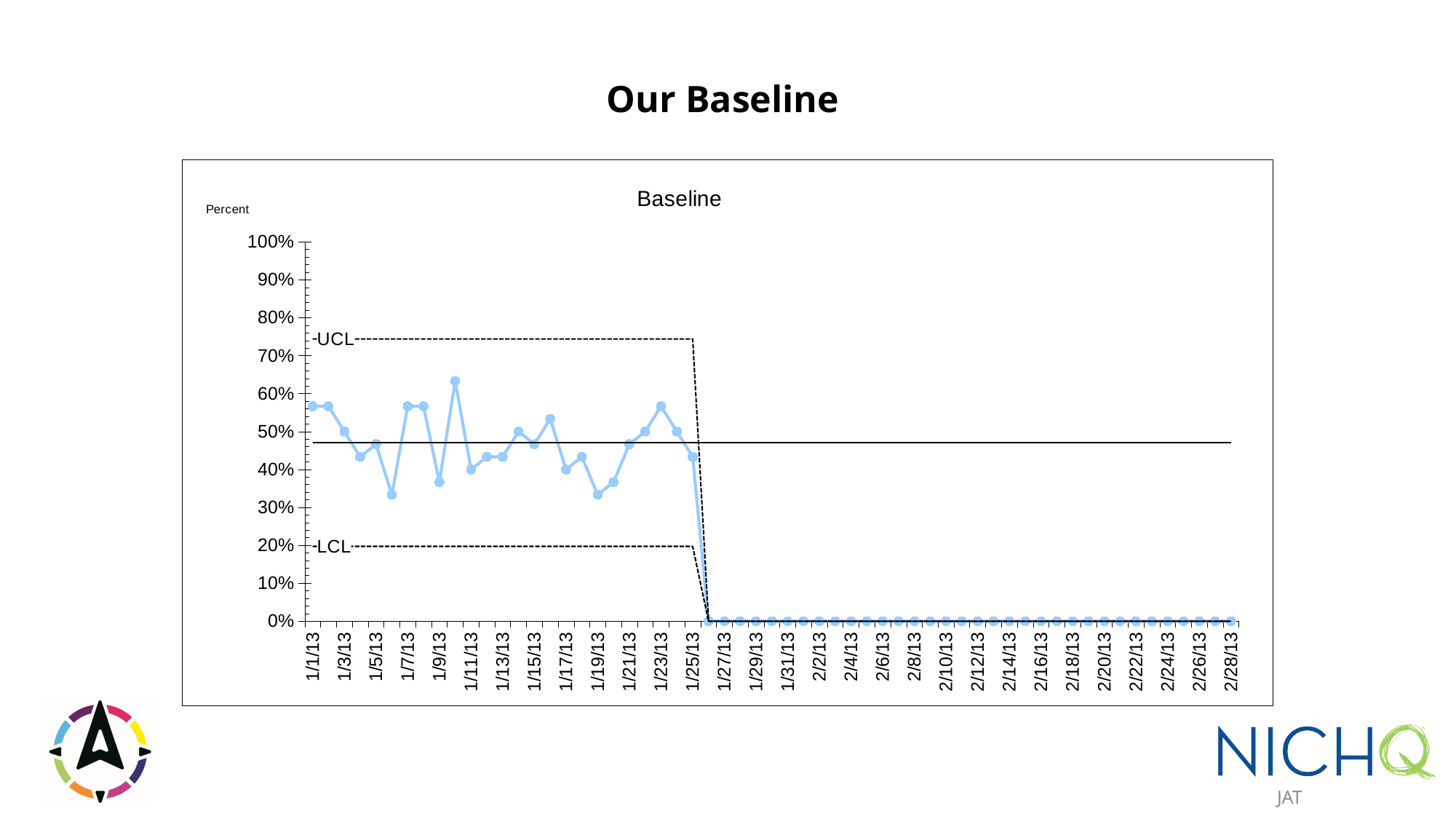
What is the value plotted for 2/14/13? 0% Which has the larger value, 1/1/13 or 1/9/13? 1/1/13 Is the value for 1/1/13 greater or less than 50%? greater Is the value for 1/25/13 greater or less than 50%? less What label is shown on the vertical axis of the chart? Percent Do the plotted values rise or fall between 1/25/13 and 1/27/13? fall Which date has the highest plotted value? 1/10/13 What is the value plotted for 1/27/13? 0% What is the title of the chart? Baseline Which has the larger value, 1/23/13 or 1/25/13? 1/23/13 Is the value for 1/9/13 greater or less than 40%? less What kind of chart is shown on the slide? line chart